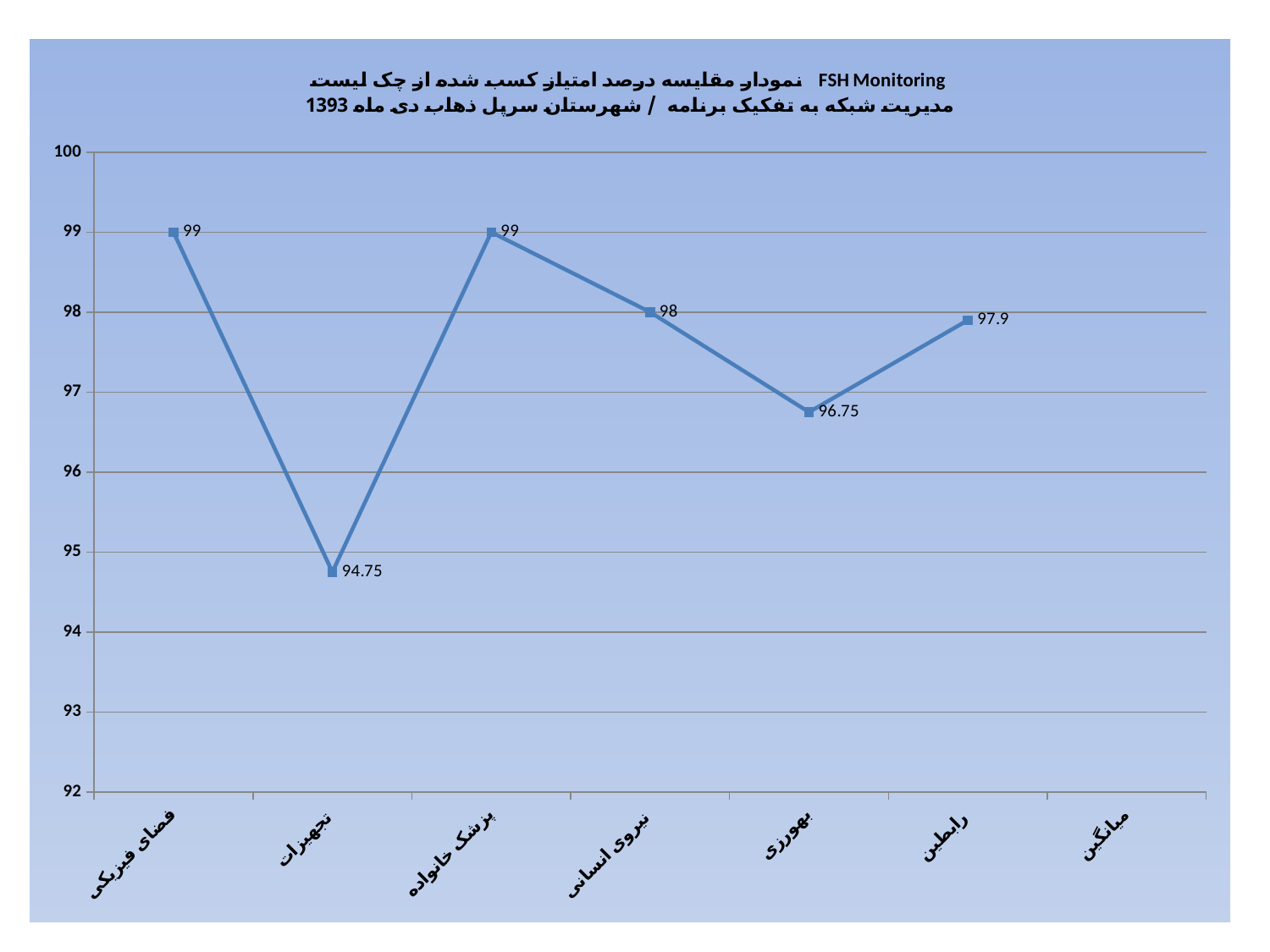
What is the value for رابطین? 97.9 What type of chart is shown on the slide? line chart What is the difference between the values for نیروی انسانی and بهورزی? 1.25 What is the value for بهورزی? 96.75 What is the value for نیروی انسانی? 98 Is the value for بهورزی greater or less than 97? less What is the highest value plotted on the chart? 99 What is the value for تجهیزات? 94.75 How many data points are plotted on the line? 6 Which is larger, the value for رابطین or the value for بهورزی? رابطین What is the difference between the values for فضای فیزیکی and تجهیزات? 4.25 Which category has the lowest value? تجهیزات